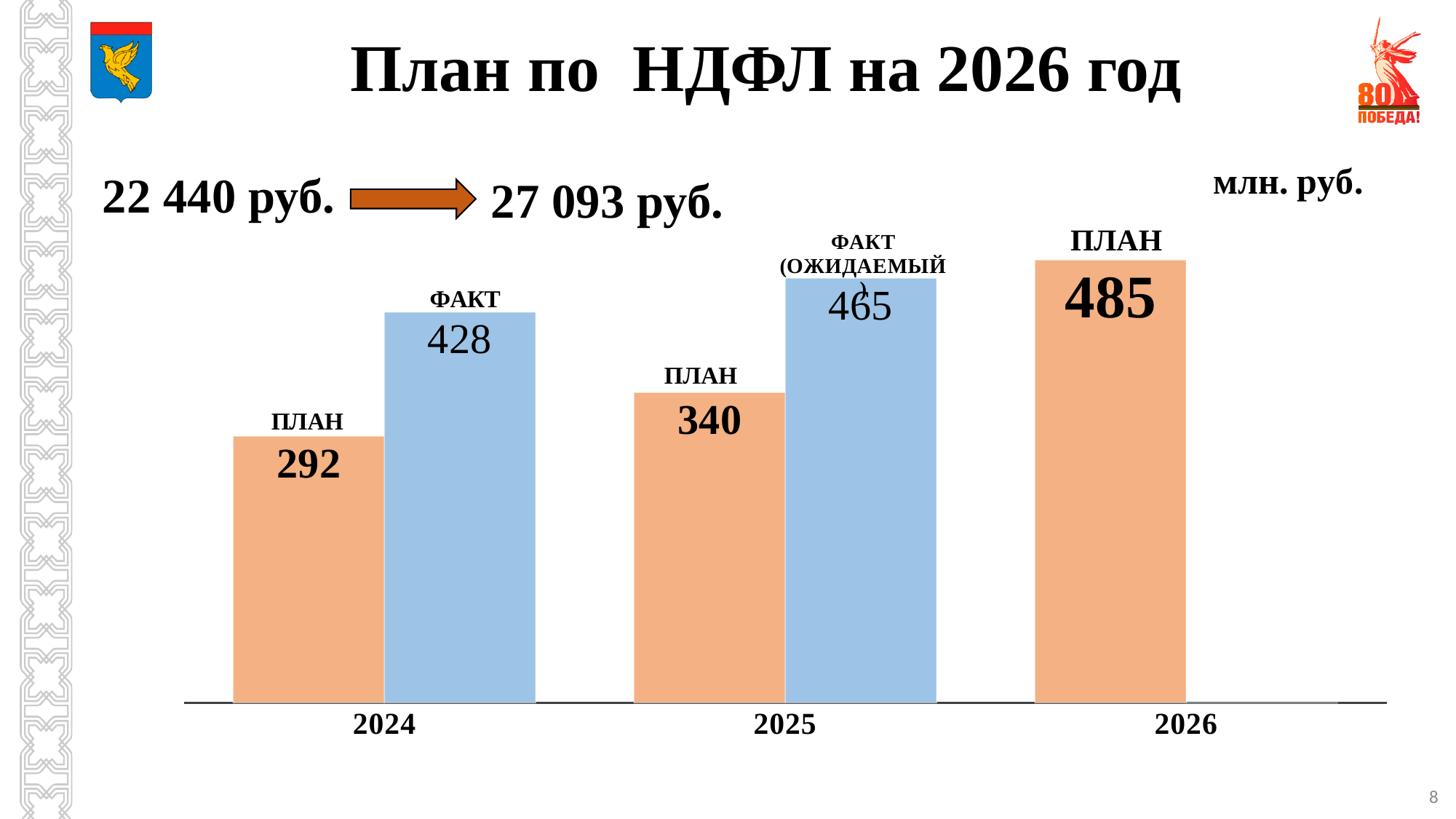
Which bar has the highest value on the chart? ПЛАН 2026 What kind of chart is shown on the slide? Bar chart How many years are shown on the x axis of the chart? 3 Which is larger, the ФАКТ (ОЖИДАЕМЫЙ) value for 2025 or the ПЛАН value for 2026? ПЛАН 2026 What is the ПЛАН value for 2025? 340 What is the ПЛАН value for 2024? 292 What is the difference between the ФАКТ and ПЛАН values for 2024? 136 What is the ФАКТ (ОЖИДАЕМЫЙ) value for 2025? 465 What is the difference between the ПЛАН values for 2026 and 2025? 145 What is the ФАКТ value for 2024? 428 What is the ПЛАН value for 2026? 485 Which bar has the lowest value on the chart? ПЛАН 2024